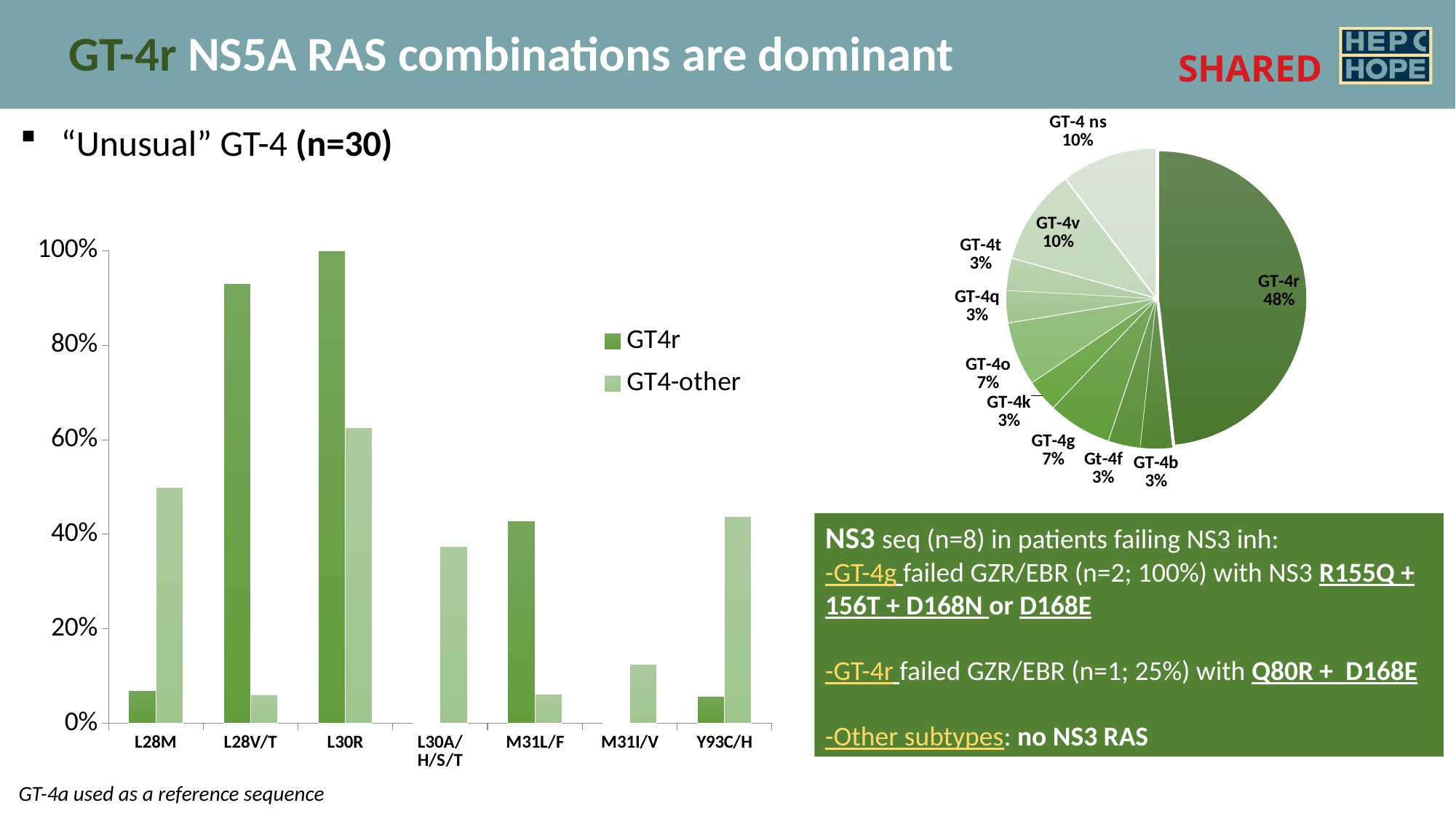
In the pie chart on the right, what is the difference between the GT-4r share and the GT-4 ns share? 38% In the bar chart on the left, for L28M, which series has the larger value, GT4r or GT4-other? GT4-other In the bar chart on the left, which category has the highest GT4r value? L30R In the pie chart on the right, what share does GT-4r have? 48% In the bar chart on the left, how many series does the legend list? 2 In the pie chart on the right, which is larger, GT-4g or GT-4k? GT-4g In the bar chart on the left, how many mutation categories are shown on the x axis? 7 In the bar chart on the left, is the GT4-other value for M31I/V greater or less than 20%? less In the bar chart on the left, is the GT4r value for L28V/T greater or less than 80%? greater In the bar chart on the left, is the GT4-other value for L28M greater or less than 40%? greater What type of chart is the chart on the left of the slide? bar chart In the bar chart on the left, what is the GT4r value for L30R? 100%